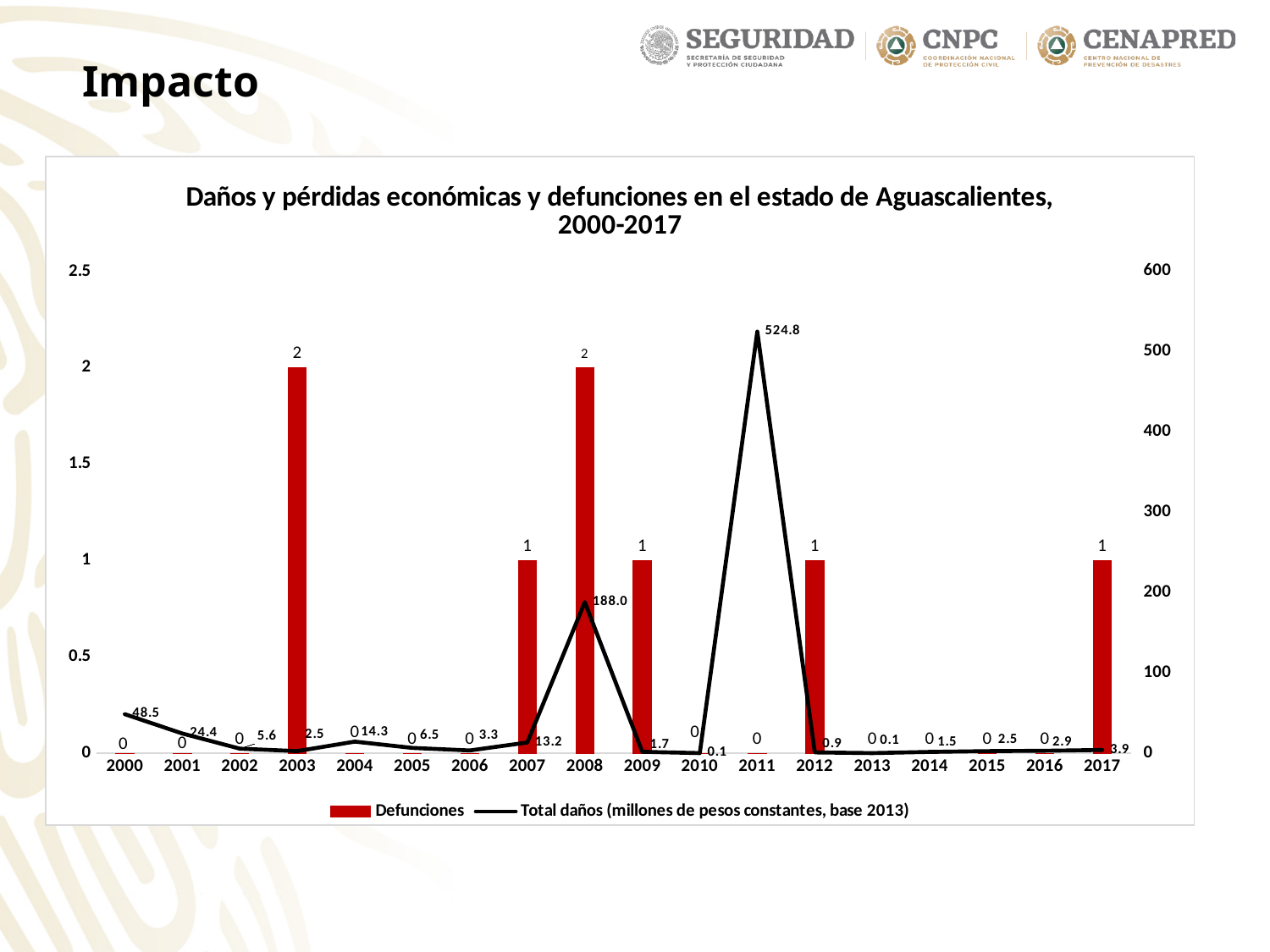
Does Total daños rise or fall from 2000 to 2003? fall How many years are shown on the x axis? 18 Which year has the highest Total daños? 2011 What is the value of Total daños (millones de pesos constantes, base 2013) for 2011? 524.8 How many series does the legend list? 2 How many Defunciones are shown for 2008? 2 Is the Total daños value for 2008 greater or less than 100? greater What is the title of the chart? Daños y pérdidas económicas y defunciones en el estado de Aguascalientes, 2000-2017 What kind of chart is used to show Defunciones? bar chart What is the difference in Total daños between 2011 and 2008? 336.8 What is the value of Total daños for 2000? 48.5 Which year has the lowest Total daños, 2010 or 2008? 2010